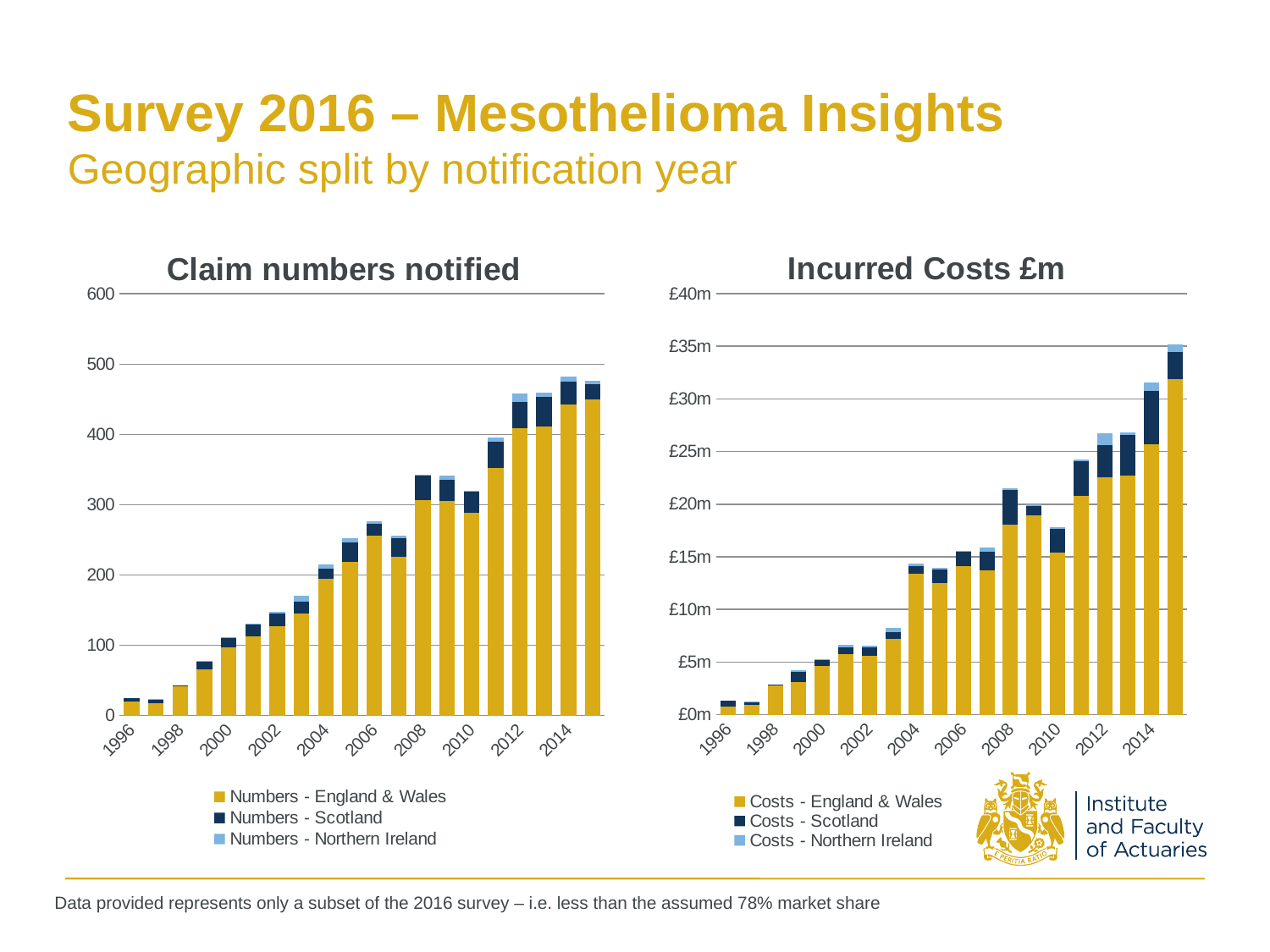
In the 'Claim numbers notified' chart, do the totals generally rise or fall from 1996 to 2015? Rise In the 'Incurred Costs £m' chart, is the total for 2004 greater or less than £15m? less What kind of chart is the 'Claim numbers notified' chart? Stacked bar chart How many series does the legend of the 'Incurred Costs £m' chart list? 3 In the 'Claim numbers notified' chart, is the total for 1998 greater or less than 100? less In the 'Incurred Costs £m' chart, which year has the highest total incurred cost? 2015 In the 'Incurred Costs £m' chart, is the total for 2015 greater or less than £30m? greater In the 'Claim numbers notified' chart, which year has the larger total: 2004 or 2008? 2008 In the 'Incurred Costs £m' chart, which year has the larger total: 2009 or 2013? 2013 In the 'Claim numbers notified' chart, which series is shown in the gold/yellow colour? Numbers - England & Wales In the 'Incurred Costs £m' chart, which series is shown in the light blue colour? Costs - Northern Ireland